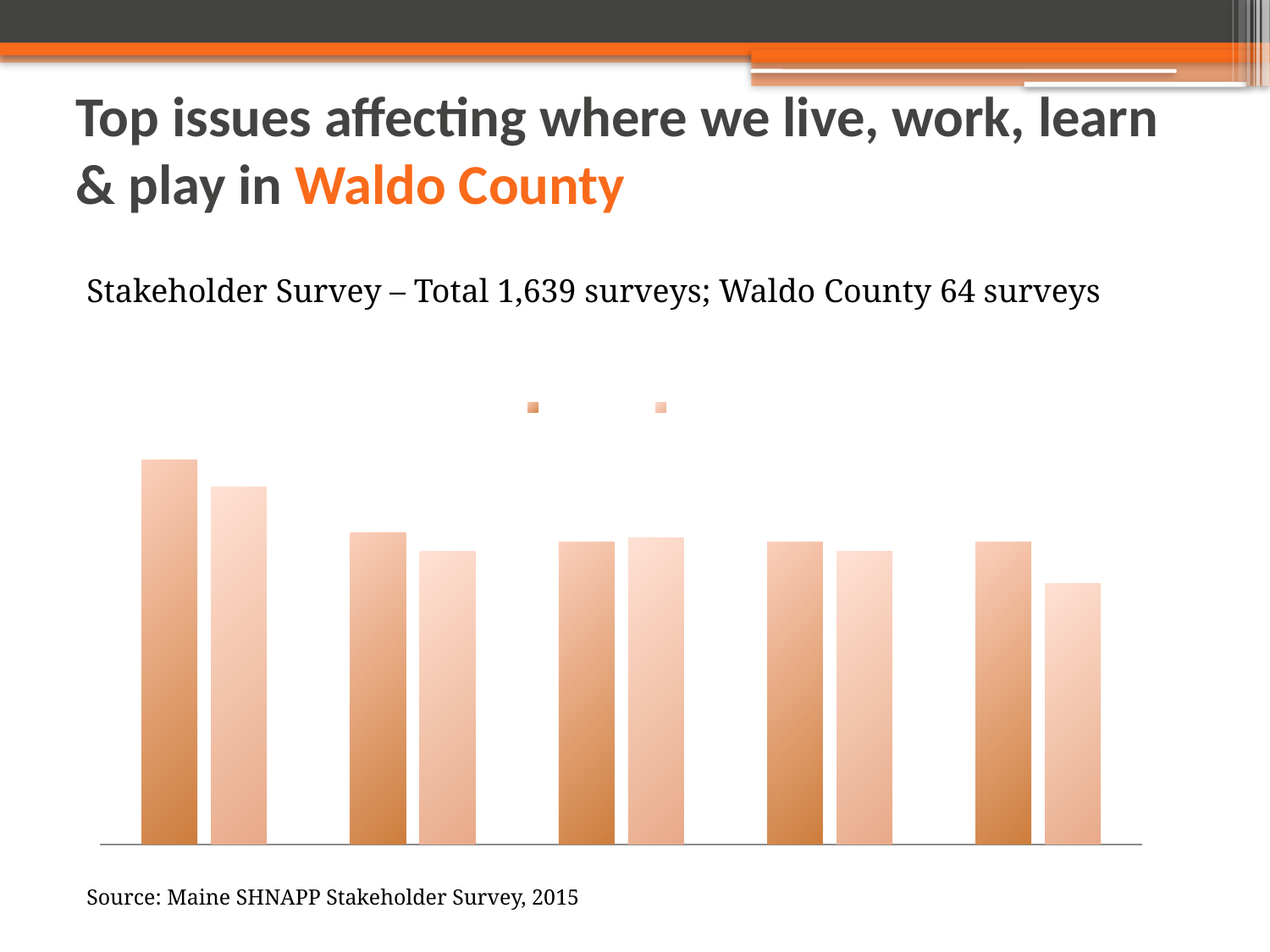
How many groups of bars are plotted in the chart? 5 Which bar is the shortest in the chart: the darker or lighter bar, and in which group from the left? the lighter bar in the fifth group In the first group of bars from the left, which is taller: the darker bar or the lighter bar? the darker bar How many bars in total are plotted in the chart? 10 How many series does the chart's legend list? 2 Do the darker bars rise or fall from the first group to the second group? fall In the second group of bars from the left, which is taller: the darker bar or the lighter bar? the darker bar Which bar is the tallest in the chart: the darker or lighter bar, and in which group from the left? the darker bar in the first group What colour family are the bars in the chart? orange In the fifth group of bars from the left, which is taller: the darker bar or the lighter bar? the darker bar What kind of chart is shown on the slide? bar chart Where is the legend positioned relative to the bars? above the bars